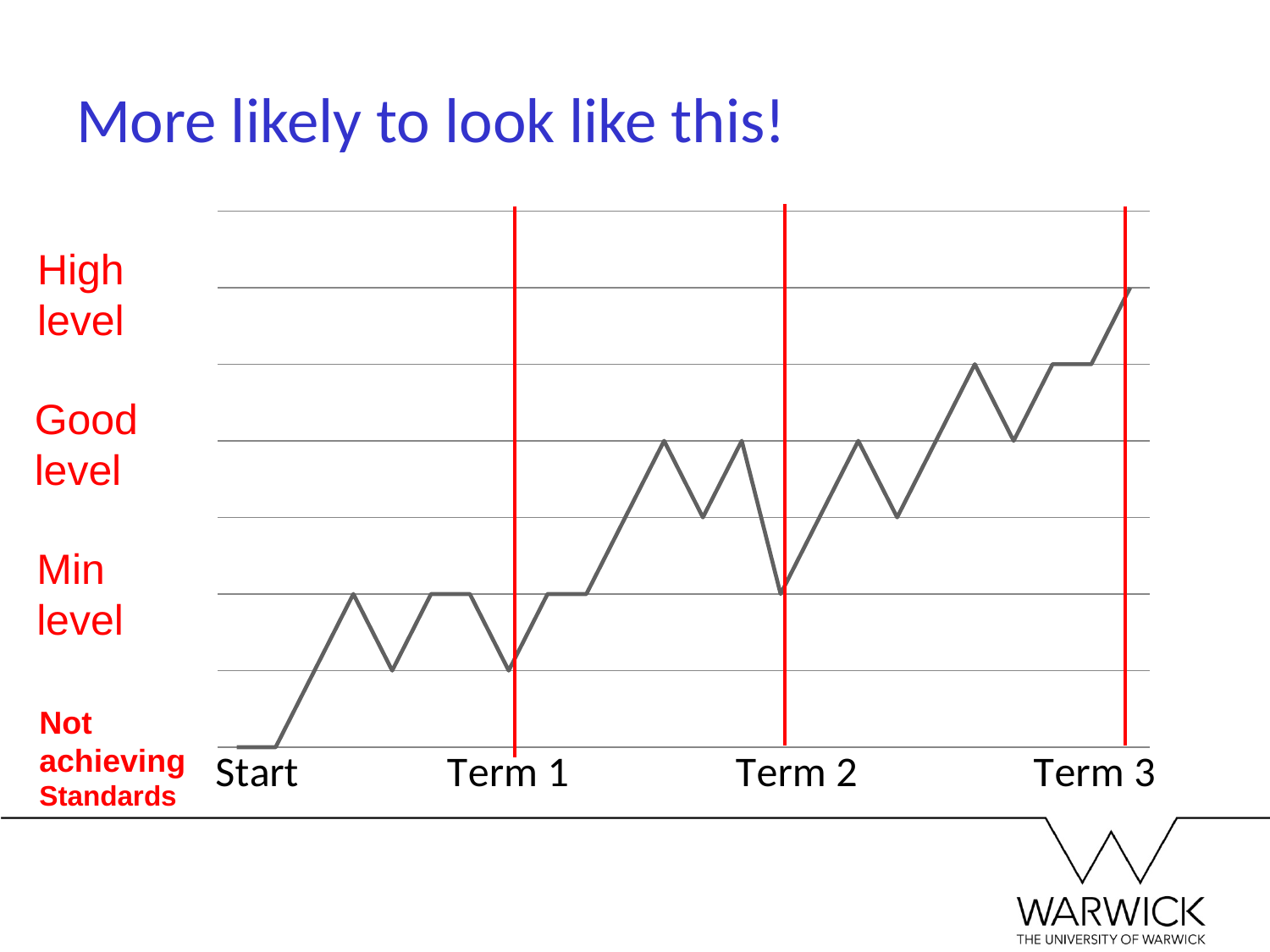
At which x-axis label is the line at its lowest point? Start How many labels are shown along the x axis of the chart? 4 What is the first label on the x axis? Start Overall, does the line rise or fall from Start to Term 3? rise What is the title of the slide above the chart? More likely to look like this! How many lines (series) are plotted on the chart? 1 At which x-axis label is the line at its highest point? Term 3 Is the line higher at Term 3 or at Start? Term 3 Is the line higher at Term 1 or at Term 2? Term 2 Is the line higher at Term 2 or at Term 3? Term 3 What kind of chart is shown on the slide? line chart